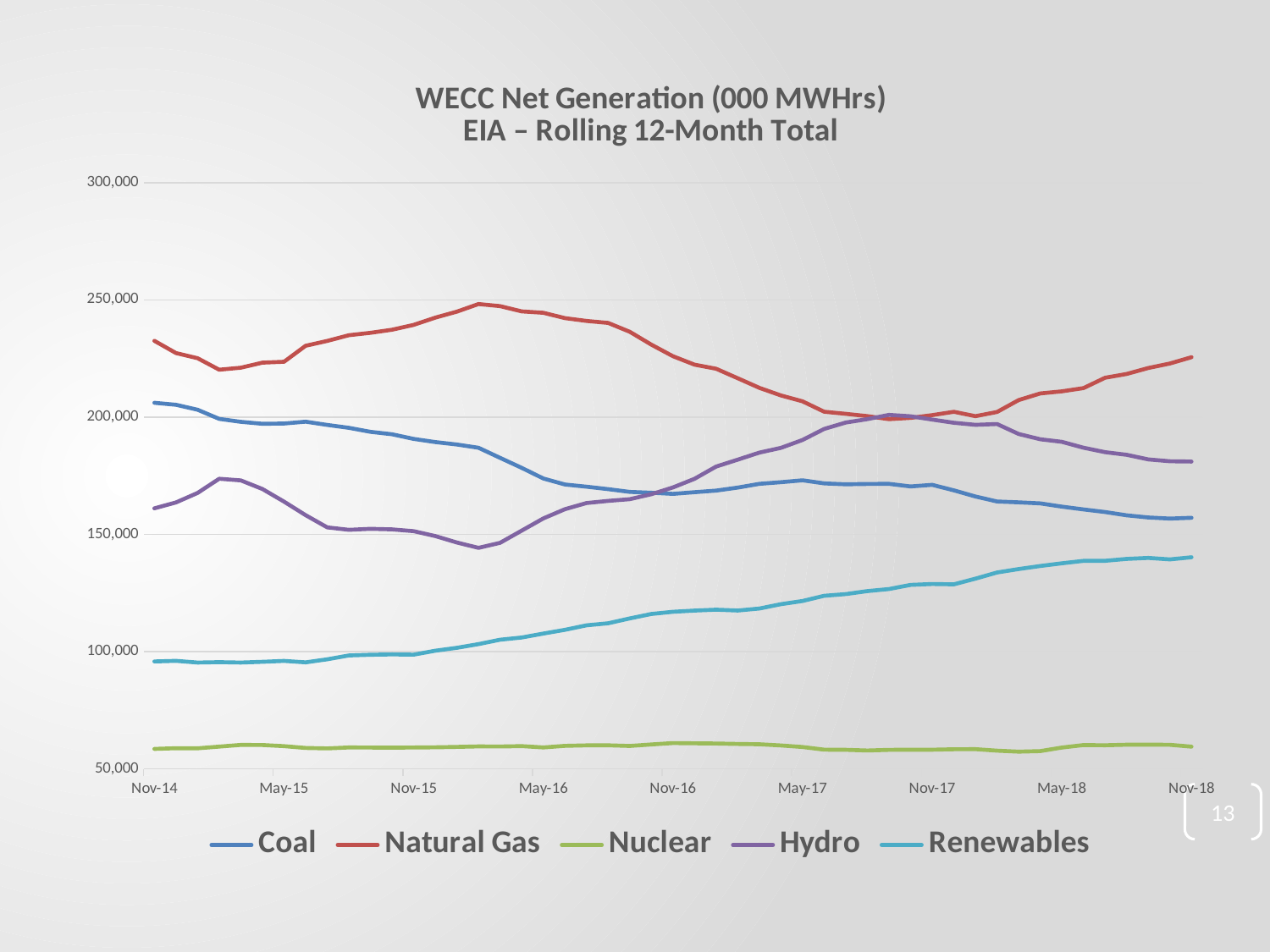
What kind of chart is shown on the slide? line chart Do the values for Renewables rise or fall from Nov-14 to Nov-18? rise Is the value for Coal at Nov-18 greater or less than 200,000? less At Nov-14, which is larger, Coal or Hydro? Coal What is the title of the chart? WECC Net Generation (000 MWHrs) EIA – Rolling 12-Month Total Do the values for Coal rise or fall from Nov-14 to Nov-18? fall Is the value for Natural Gas at Nov-18 greater or less than 200,000? greater Which series has the highest value at Nov-14? Natural Gas Is the value for Nuclear at Nov-18 greater or less than 100,000? less How many series does the legend list? 5 At Nov-18, which is larger, Hydro or Coal? Hydro Which series has the lowest value at Nov-18? Nuclear